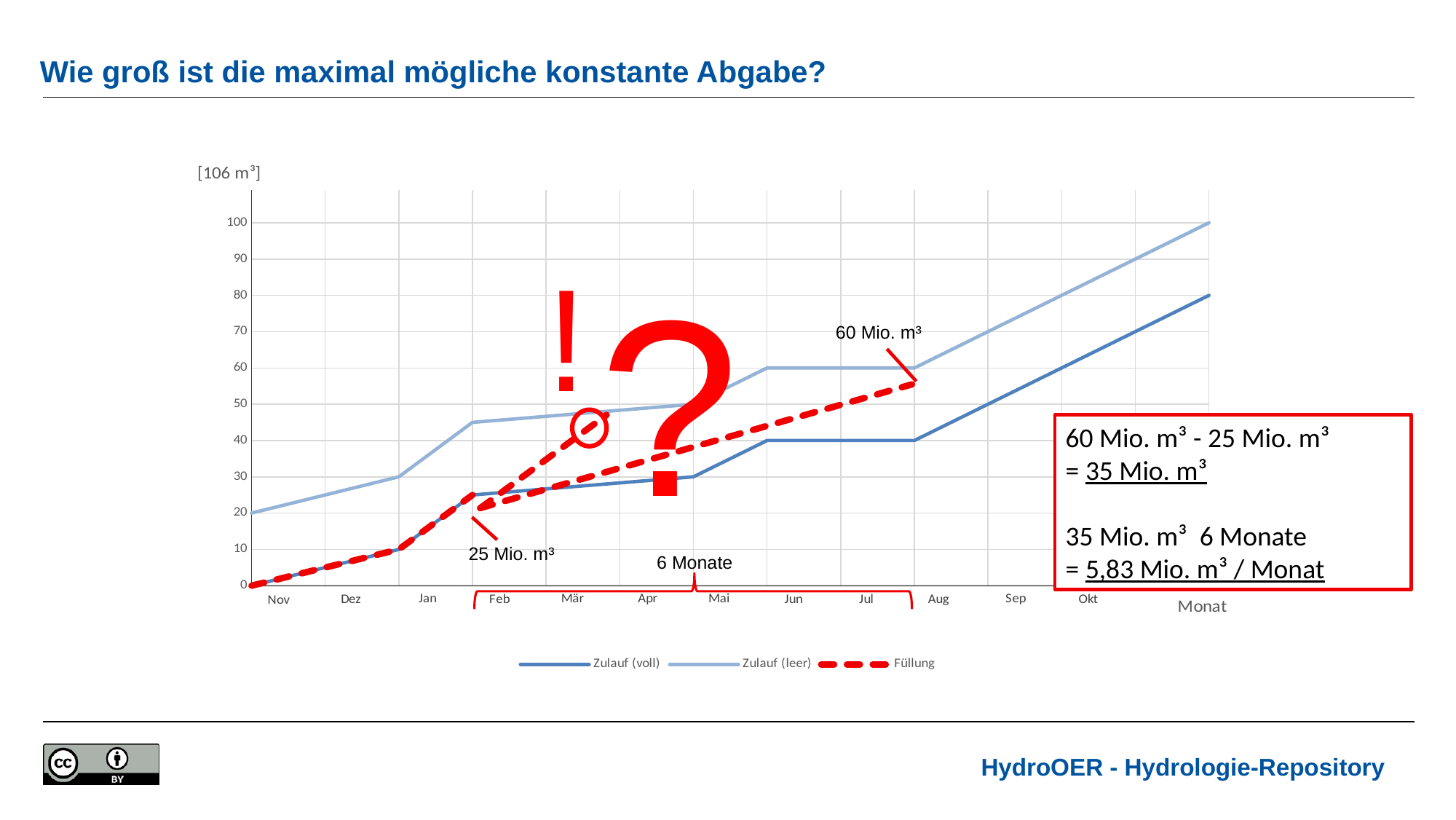
What are the three entries in the chart legend? Zulauf (voll), Zulauf (leer), Füllung What value does the Zulauf (leer) line reach at the end of Okt? 100 What value does the Zulauf (voll) line reach at the end of Okt? 80 How many months are labelled on the x axis? 12 Is the value of Zulauf (voll) during Jun greater or less than 50? less At what value does the Zulauf (voll) line plateau during Jun and Jul? 40 What is the difference between the Zulauf (leer) plateau and the Zulauf (voll) plateau during Jun and Jul? 20 At what value does the Zulauf (leer) line plateau during Jun and Jul? 60 Does the Zulauf (leer) line rise or fall from Nov to Okt? rise Which series is higher at the end of Okt, Zulauf (leer) or Zulauf (voll)? Zulauf (leer) How many series does the legend list? 3 What kind of chart is shown on the slide? line chart